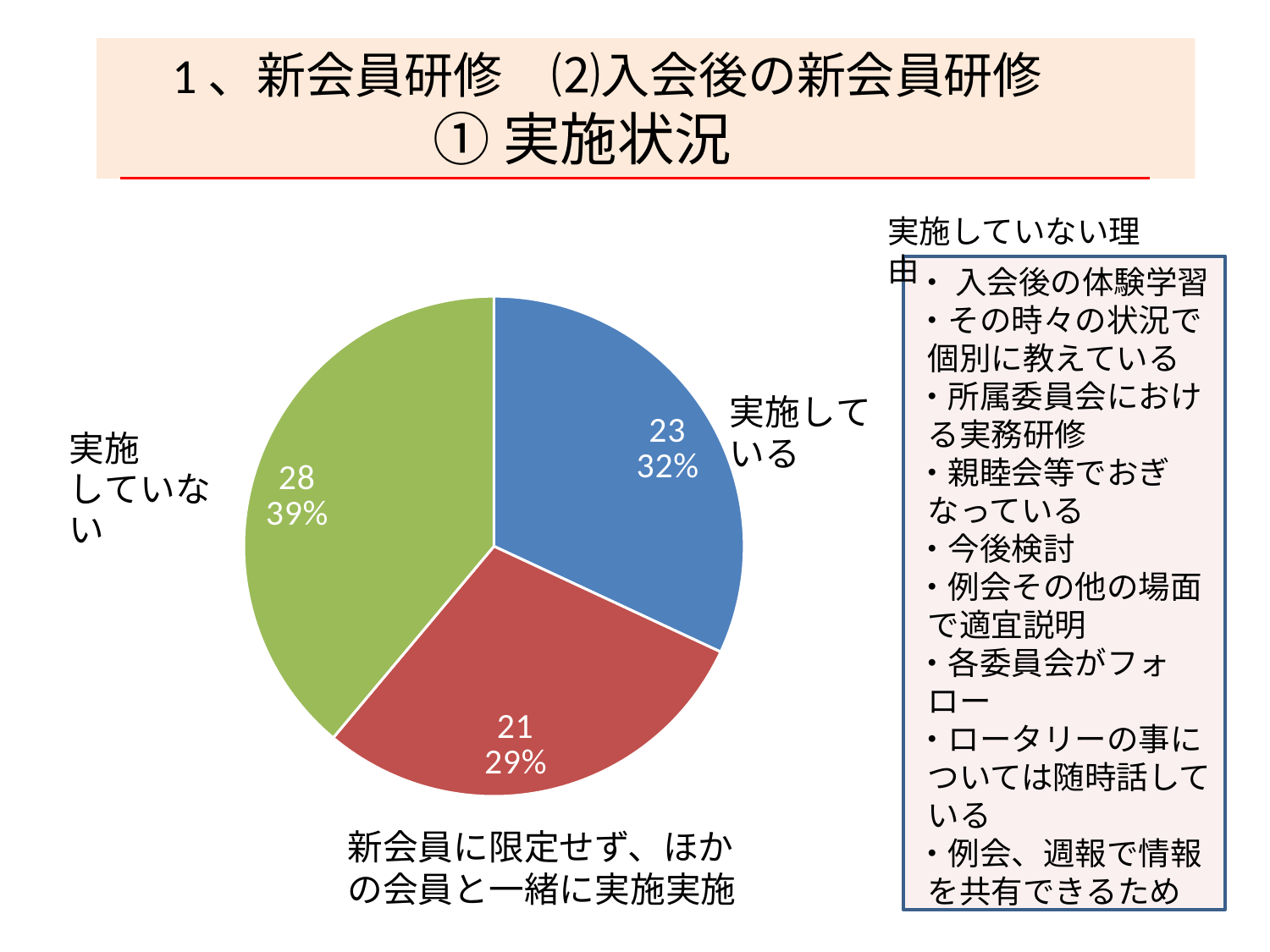
What is the count shown for the 実施している slice? 23 What kind of chart is shown on the slide? pie chart Which slice of the pie chart is the largest? 実施していない What percentage is shown for the 実施している slice? 32% Which slice of the pie chart is the smallest? 新会員に限定せず、ほかの会員と一緒に実施実施 What is the difference in count between the 実施していない slice and the 実施している slice? 5 What is the total count across all three slices of the pie chart? 72 What is the count shown for the 新会員に限定せず、ほかの会員と一緒に実施実施 slice? 21 What colour is the 実施していない slice? green Which is larger, the count for 実施している or the count for 新会員に限定せず、ほかの会員と一緒に実施実施? 実施している How many slices does the pie chart have? 3 What percentage is shown for the 実施していない slice? 39%